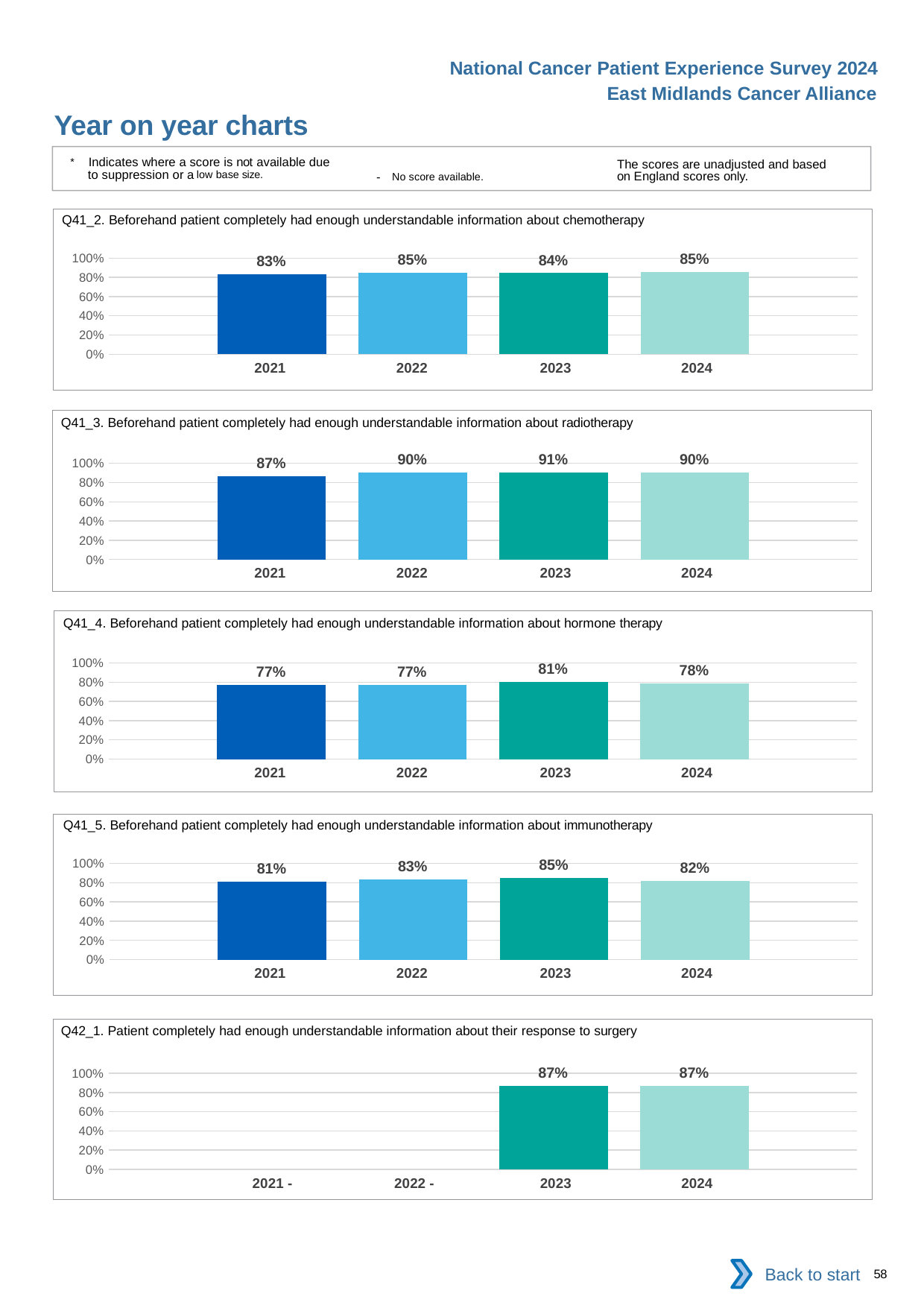
In the Q42_1 chart (response to surgery), what is the value for 2024? 87% In the Q41_4 chart (hormone therapy), what is the value for 2023? 81% In the Q41_4 chart (hormone therapy), which year has the lowest value? 2021 and 2022 (both 77%) How many charts are shown on the slide? 5 In the Q41_3 chart (radiotherapy), what is the difference between the 2023 value and the 2021 value? 4% In the Q41_3 chart (radiotherapy), which year has the highest value? 2023 In the Q41_5 chart (immunotherapy), what is the difference between the 2023 value and the 2021 value? 4% In the Q41_5 chart (immunotherapy), is the value for 2023 larger than the value for 2024? Yes In the Q41_2 chart (chemotherapy), is the value for 2022 greater or less than 80%? greater What kind of chart is the Q41_3 chart (radiotherapy)? Bar chart In the Q41_2 chart (chemotherapy), what is the value for 2021? 83% In the Q42_1 chart (response to surgery), how many years have a bar plotted? 2